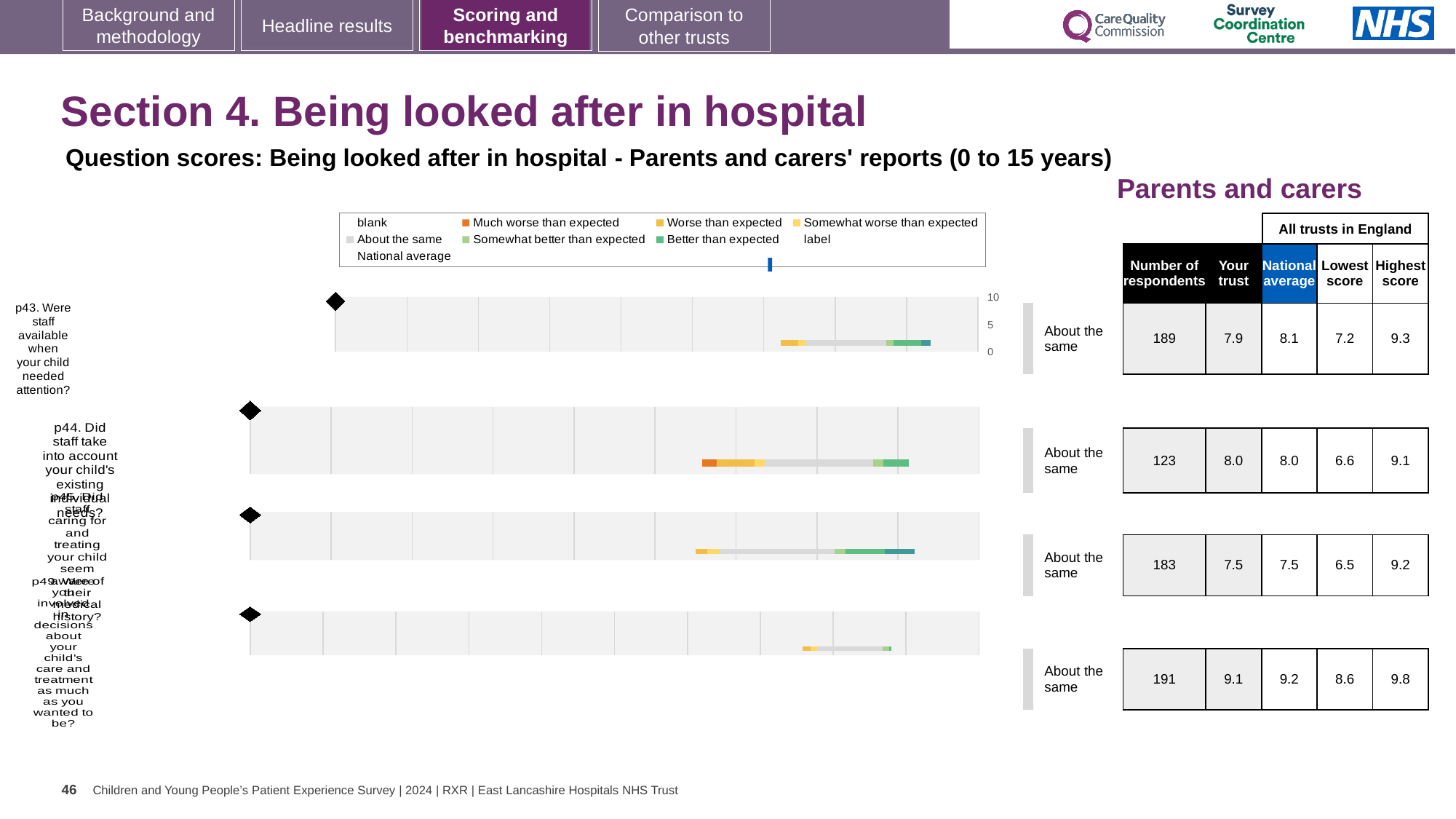
What is the number of respondents for question p43 (Were staff available when your child needed attention?)? 189 For question p43, what is the difference between the highest score (9.3) and the lowest score (7.2) across all trusts in England? 2.1 What is the highest score across all trusts in England for question p49 (Were you involved in decisions about your child's care and treatment as much as you wanted to be?)? 9.8 How many survey questions (p43, p44, p45, p49) are plotted on the slide? 4 For question p43, which is larger: the 'Your trust' score or the national average? National average Which question has the lowest 'Your trust' score? p45 Which question has the highest 'Your trust' score? p49 What is the national average score for question p45 (Did staff caring for and treating your child seem aware of their medical history?)? 7.5 In the legend, what colour represents 'Much worse than expected'? Orange What is the 'Your trust' score for question p44 (Did staff take into account your child's existing individual needs?)? 8.0 What benchmark category is shown for all four questions on this slide? About the same What kind of chart is used to show the question scores on this slide? bar chart